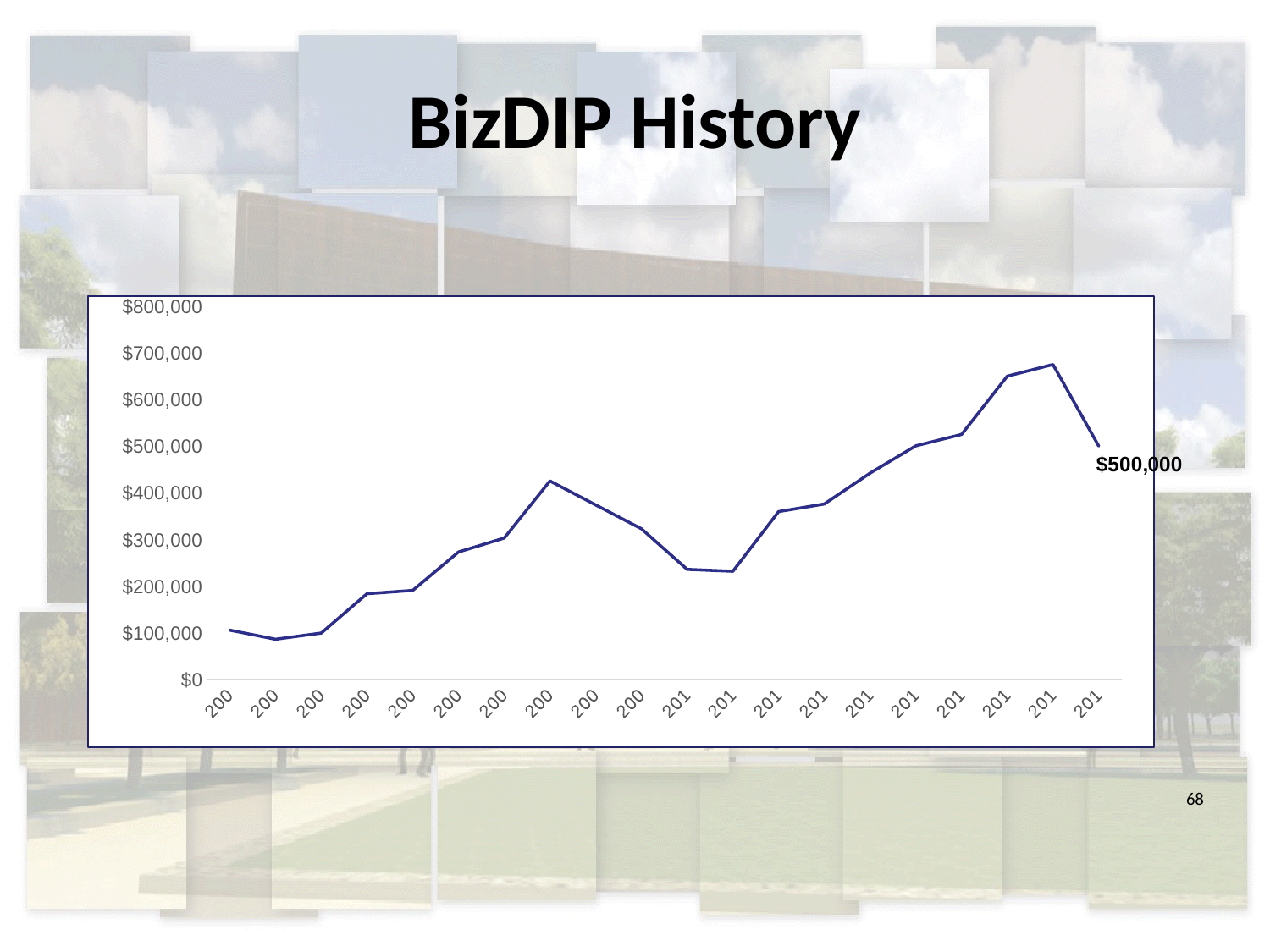
Which is larger, the peak value of the line or the final value of $500,000? the peak value Overall, do the values rise or fall from the left of the x axis to the right? rise Is the lowest point on the line greater or less than $100,000? less Is the last point on the line greater or less than $400,000? greater Is the first point on the line greater or less than $200,000? less What value is printed as a data label at the last point of the line? $500,000 What is the title of the slide containing the chart? BizDIP History What is the highest value shown on the y axis? $800,000 Does the line rise or fall between the second-to-last point and the last point? fall What kind of chart is shown on the slide? line chart How many data points are plotted on the line? 20